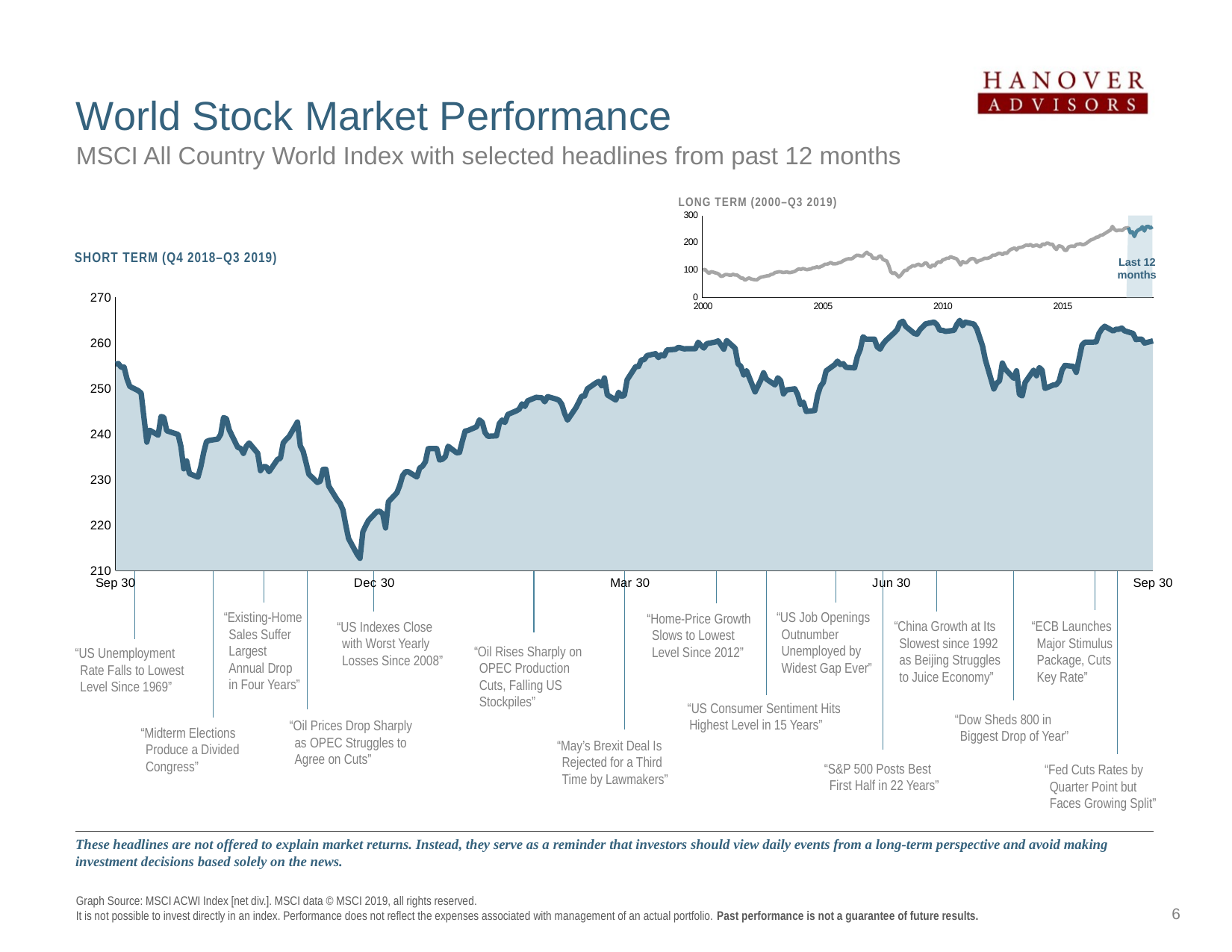
What is the highest value shown on the y axis of the short-term chart? 270 On the long-term chart, does the index rise or fall between 2010 and 2015? rise On the short-term chart, does the index generally rise or fall between Sep 30 and Dec 30? fall On the long-term chart, is the index value around 2003 greater or less than 100? less On the short-term chart, is the index value at the final Sep 30 greater or less than 250? greater On the long-term chart (2000–Q3 2019), is the index value at the end of the series (Q3 2019) greater or less than 200? greater What kind of chart is the short-term chart (Q4 2018–Q3 2019)? line chart On the short-term chart, does the index generally rise or fall between Dec 30 and Mar 30? rise What label is given to the shaded region at the right end of the long-term chart? Last 12 months How many date labels are shown on the x axis of the short-term chart? 5